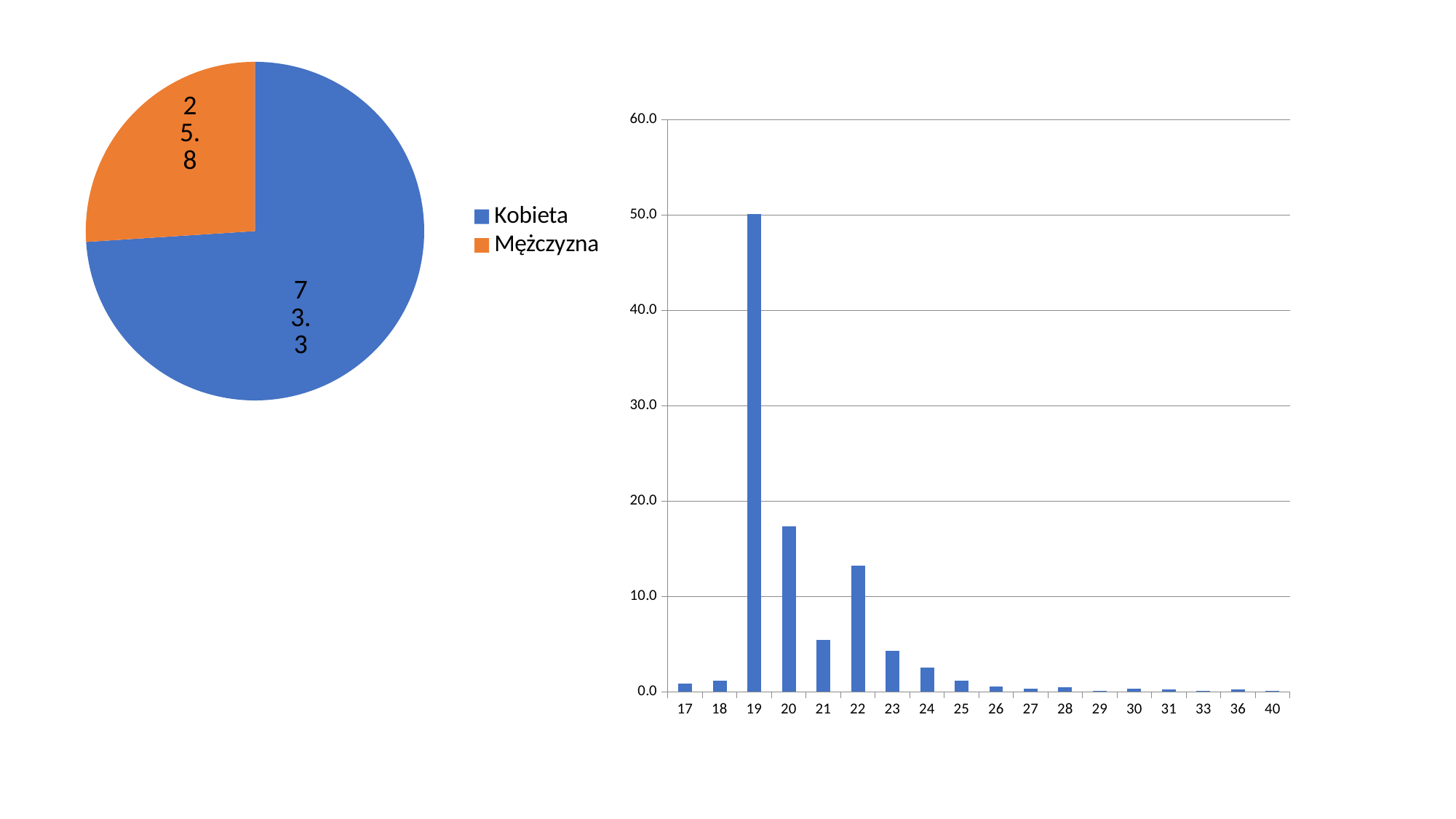
In the pie chart on the left, what value is shown for Mężczyzna? 25.8 In the bar chart on the right, which is larger, the value for 21 or the value for 22? 22 In the pie chart on the left, what value is shown for Kobieta? 73.3 In the pie chart on the left, what is the difference between the Kobieta and Mężczyzna values? 47.5 What kind of chart is on the right side of the slide? Bar chart In the bar chart on the right, is the value for 22 greater or less than 10.0? greater In the bar chart on the right, which category has the highest bar? 19 In the bar chart on the right, is the value for 20 greater or less than 20.0? less In the bar chart on the right, how many categories are shown on the x axis? 18 In the pie chart on the left, what colour is the Mężczyzna slice? Orange How many entries does the legend of the pie chart on the left list? 2 In the pie chart on the left, which category has the larger slice? Kobieta